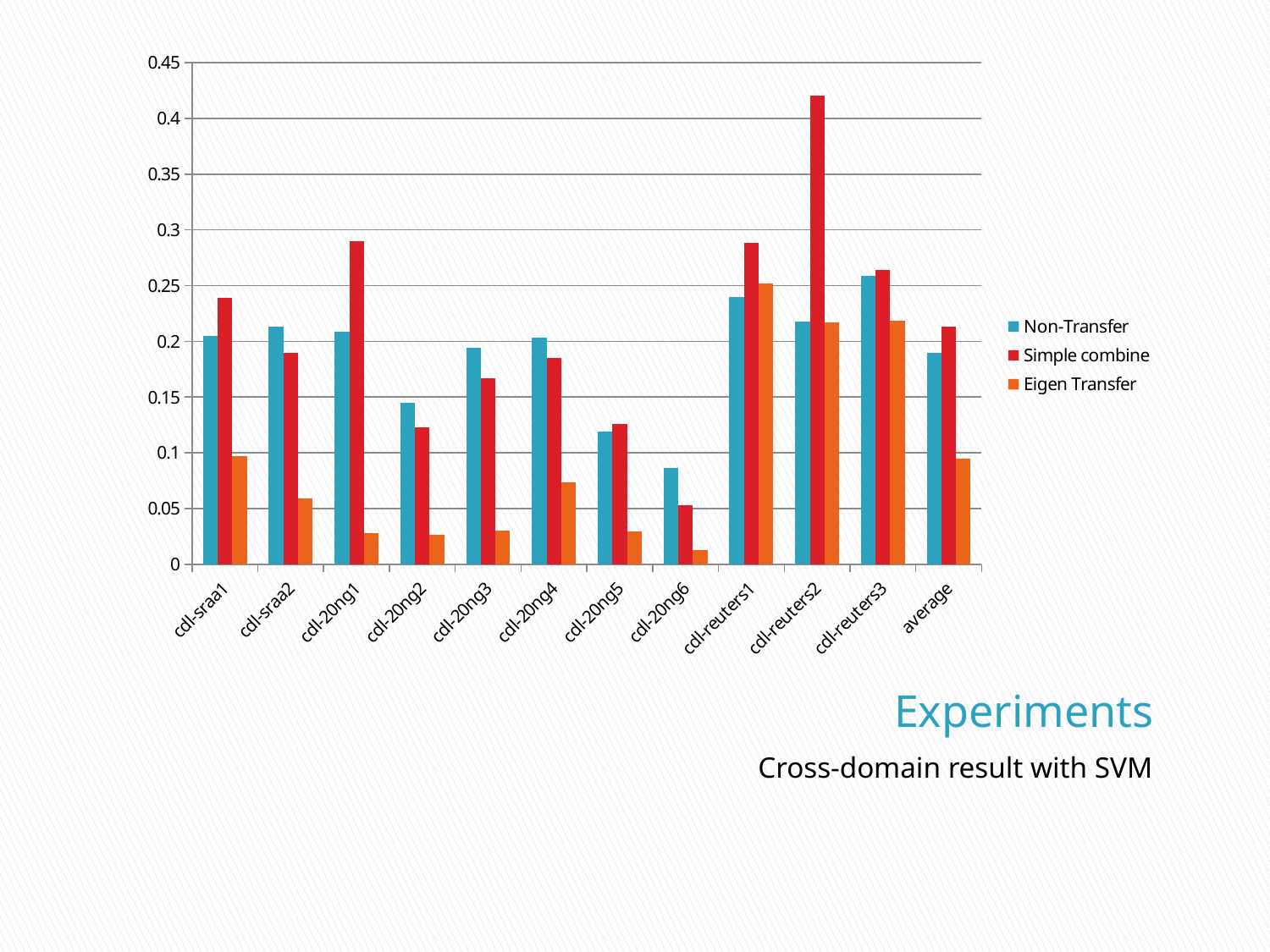
For cdl-20ng6, which is larger: Non-Transfer or Simple combine? Non-Transfer Which category has the lowest Non-Transfer value? cdl-20ng6 Which category has the lowest Eigen Transfer value? cdl-20ng6 How many series does the legend list? 3 What kind of chart is shown on the slide? bar chart What are the three series named in the legend? Non-Transfer, Simple combine, Eigen Transfer Which category has the highest Simple combine value? cdl-reuters2 Is the Eigen Transfer value for cdl-20ng1 greater or less than 0.05? less Is the Non-Transfer value for cdl-20ng6 greater or less than 0.1? less For cdl-20ng1, which is larger: Non-Transfer or Simple combine? Simple combine Is the Simple combine value for cdl-reuters2 greater or less than 0.4? greater How many categories are shown along the x axis? 12